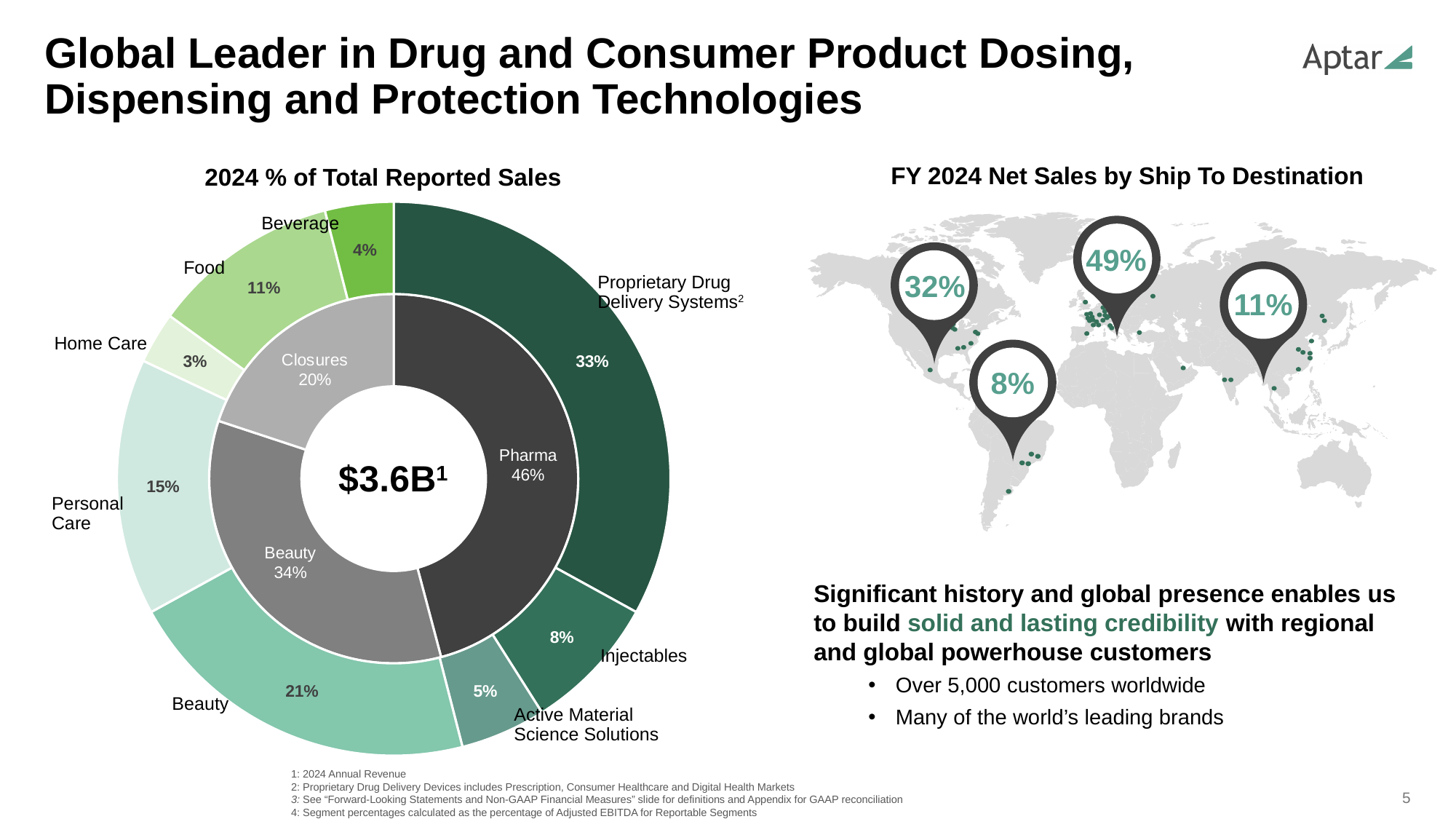
In the 2024 % of Total Reported Sales chart, how many percentage points larger is the outer-ring Beauty segment (21%) than Personal Care (15%)? 6 percentage points In the 2024 % of Total Reported Sales chart, what percentage is shown for Closures? 20% In the FY 2024 Net Sales by Ship To Destination map, what is the largest percentage shown? 49% What value is shown in the center of the 2024 % of Total Reported Sales chart? $3.6B In the 2024 % of Total Reported Sales chart, what share does Pharma hold in the inner ring? 46% In the 2024 % of Total Reported Sales chart, how many segments are in the outer ring? 8 In the 2024 % of Total Reported Sales chart, which inner-ring segment is the largest? Pharma In the 2024 % of Total Reported Sales chart, what is the sum of the outer-ring segments Proprietary Drug Delivery Systems, Injectables and Active Material Science Solutions? 46% What kind of chart is the 2024 % of Total Reported Sales chart? Donut (pie) chart In the 2024 % of Total Reported Sales chart, which outer-ring segment has the smallest percentage? Home Care In the 2024 % of Total Reported Sales chart, which is larger: Food or Injectables? Food In the 2024 % of Total Reported Sales chart, what percentage is shown for Proprietary Drug Delivery Systems? 33%